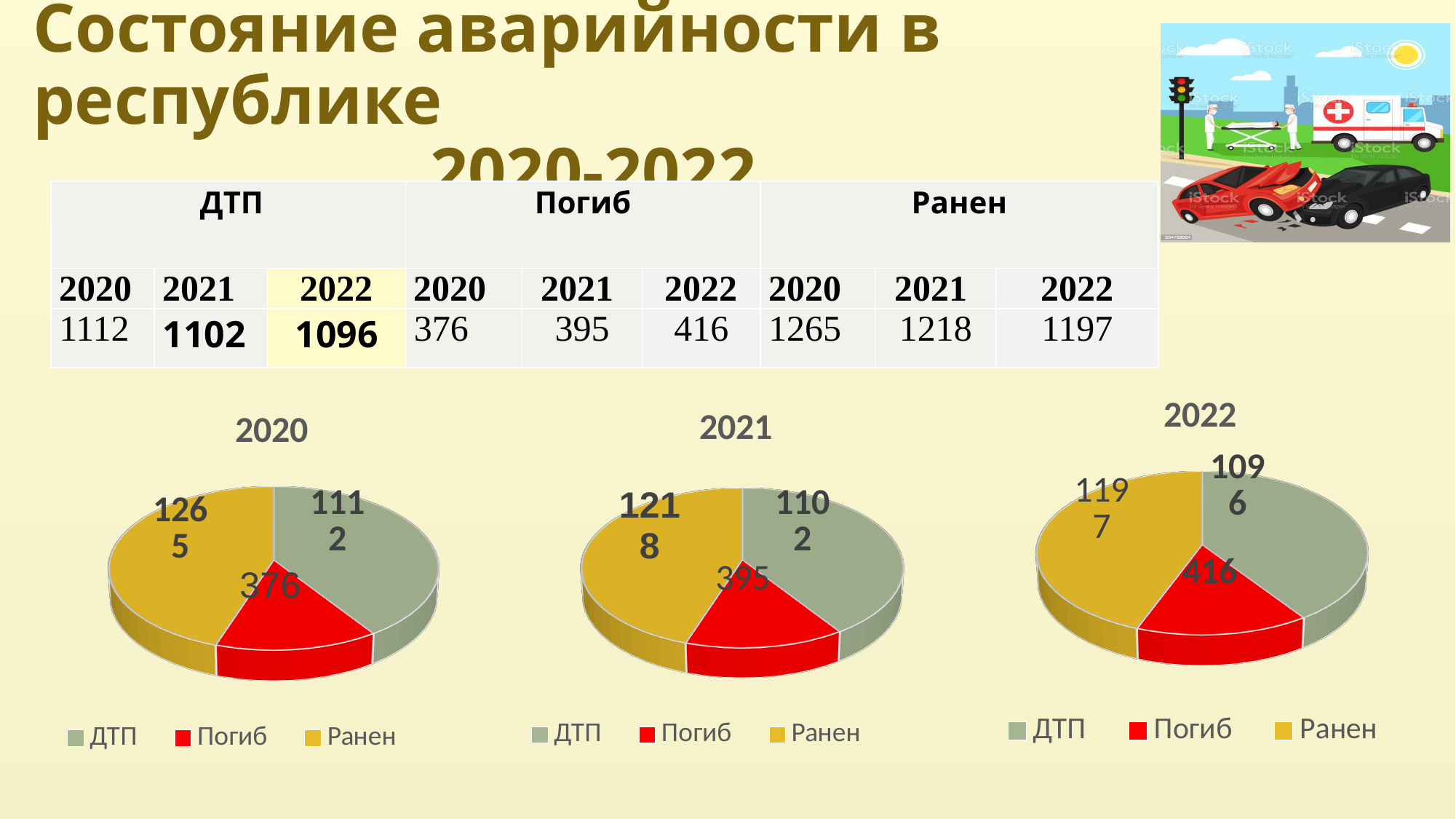
In the pie chart titled 2021, what colour is the Погиб slice? Red How many slices does the pie chart titled 2020 have? 3 In the pie chart titled 2020, what is the total of all three slices? 2753 In the pie chart titled 2022, which category has the largest slice? Ранен What kind of chart is the chart titled 2022? Pie chart In the pie chart titled 2020, what is the value for Погиб? 376 In the pie chart titled 2021, what is the difference between the values for Ранен and ДТП? 116 In the pie chart titled 2020, which category has the smallest slice? Погиб In the pie chart titled 2022, what is the value for ДТП? 1096 How many entries does the legend of the pie chart titled 2021 list? 3 In the pie chart titled 2021, what is the value for Ранен? 1218 In the pie chart titled 2022, which is larger, the value for ДТП or the value for Погиб? ДТП